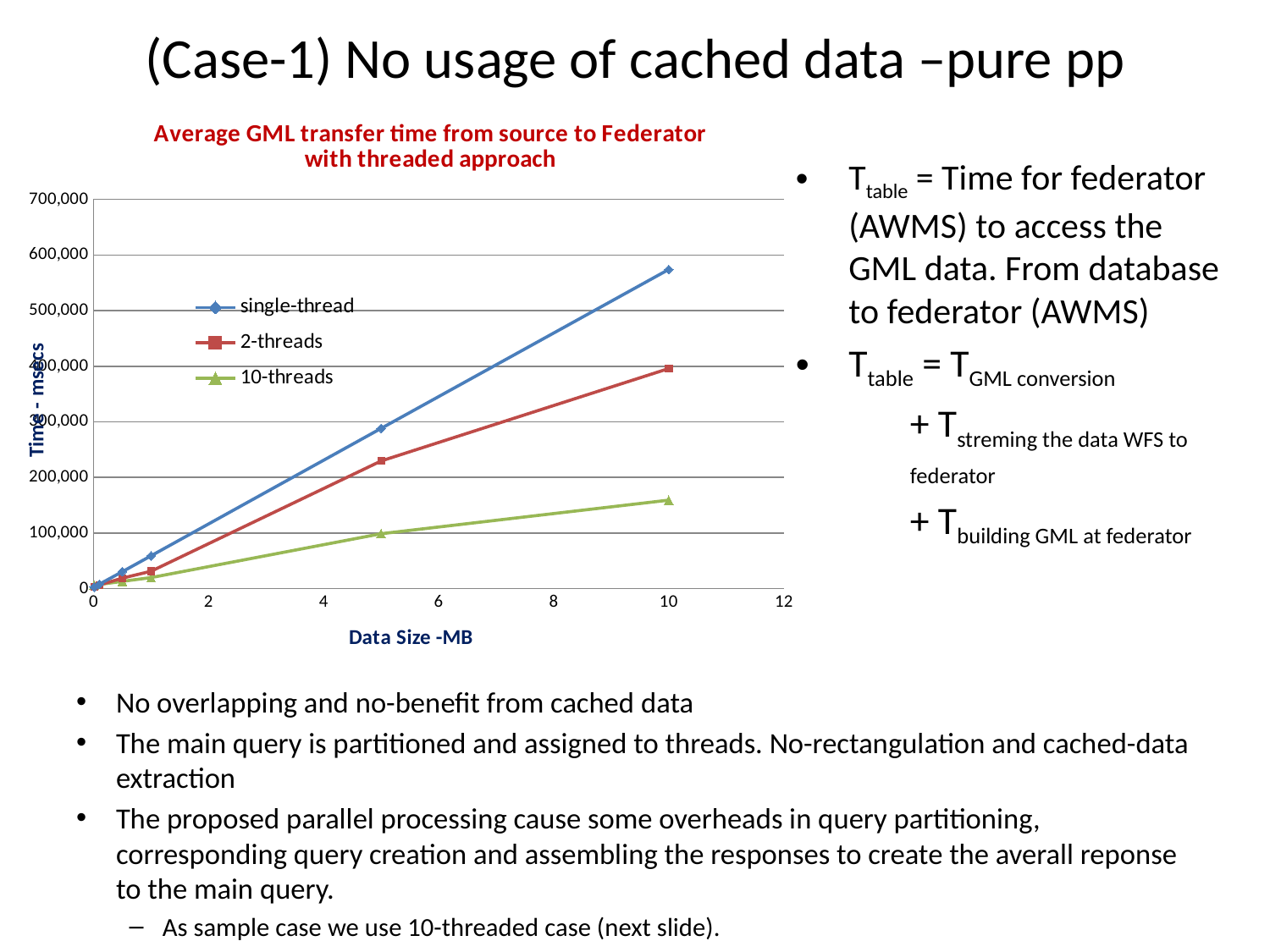
Is the single-thread value at 5 MB greater or less than 200,000? greater Is the 10-threads value at 10 MB greater or less than 200,000? less What kind of chart is shown on the slide? line chart Do the transfer times rise or fall as data size increases along the x axis? rise Which series has the highest transfer time at a data size of 10 MB? single-thread Is the 2-threads value at 10 MB greater or less than 300,000? greater What is the title of the chart? Average GML transfer time from source to Federator with threaded approach Which series has the lowest transfer time at a data size of 10 MB? 10-threads At a data size of 5 MB, which is larger: the single-thread value or the 10-threads value? single-thread How many series does the chart's legend list? 3 What is the label of the chart's x axis? Data Size -MB